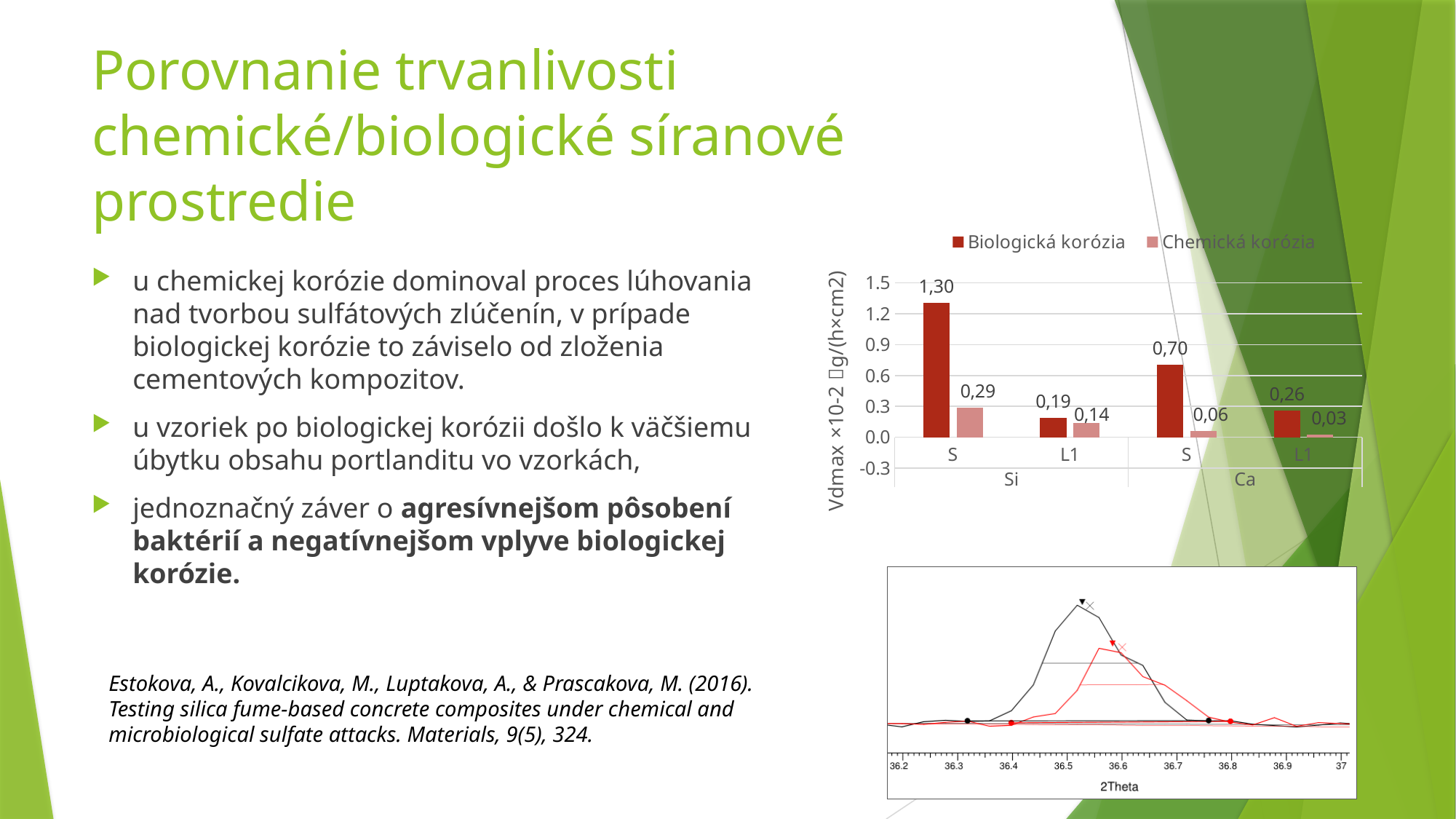
In the upper bar chart, which is larger for L1 in the Si group: Biologická korózia or Chemická korózia? Biologická korózia What is the x-axis label of the lower chart on the slide? 2Theta What kind of chart is the upper chart on the slide? Bar chart How many series does the legend of the upper bar chart list? 2 In the upper bar chart, is the Biologická korózia value for S in the Si group greater or less than 1.2? greater In the upper bar chart, what is the value of Chemická korózia for L1 in the Ca group? 0,03 In the upper bar chart, what is the value of Biologická korózia for S in the Si group? 1,30 In the upper bar chart, what is the difference between Biologická korózia and Chemická korózia for S in the Ca group? 0,64 In the upper bar chart, what is the value of Chemická korózia for S in the Si group? 0,29 In the upper bar chart, which category has the lowest Chemická korózia value? L1 (Ca) In the upper bar chart, which category has the highest Biologická korózia value? S (Si) In the upper bar chart, what is the value of Biologická korózia for S in the Ca group? 0,70